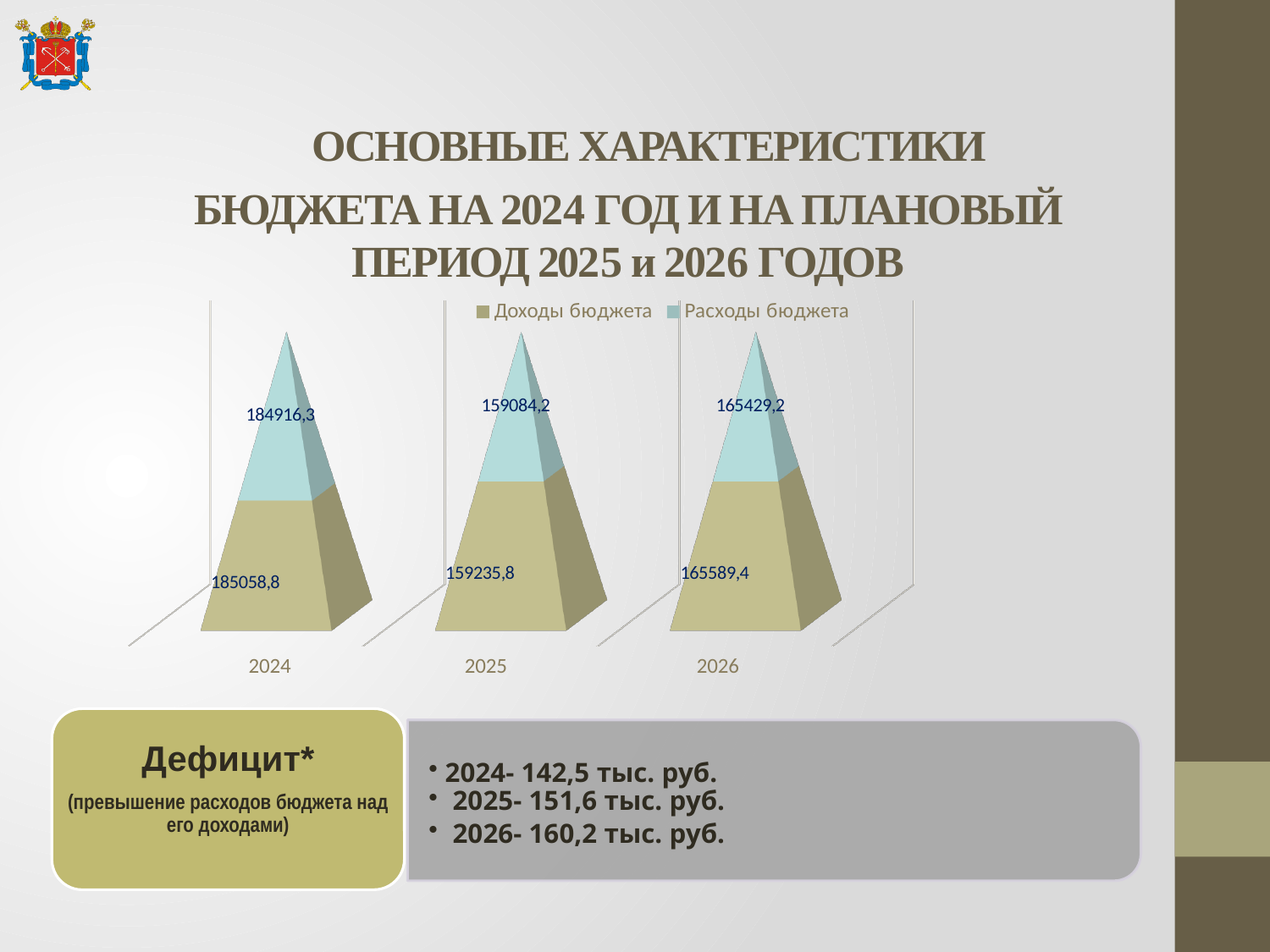
In which year is Доходы бюджета the highest? 2024 What is the difference between Доходы бюджета in 2024 and in 2025? 25823,0 What is the value of Расходы бюджета for 2025? 159084,2 What is the total of the stacked bar for 2026? 331018,6 Which is larger: Доходы бюджета in 2024 or in 2026? 2024 How many series does the chart legend list? 2 What is the value of Расходы бюджета for 2026? 165429,2 How many years are shown on the x axis of the chart? 3 In which year is Расходы бюджета the lowest? 2025 What is the value of Доходы бюджета for 2025? 159235,8 What is the value of Доходы бюджета for 2024? 185058,8 What is the difference between Доходы бюджета and Расходы бюджета in 2024? 142,5